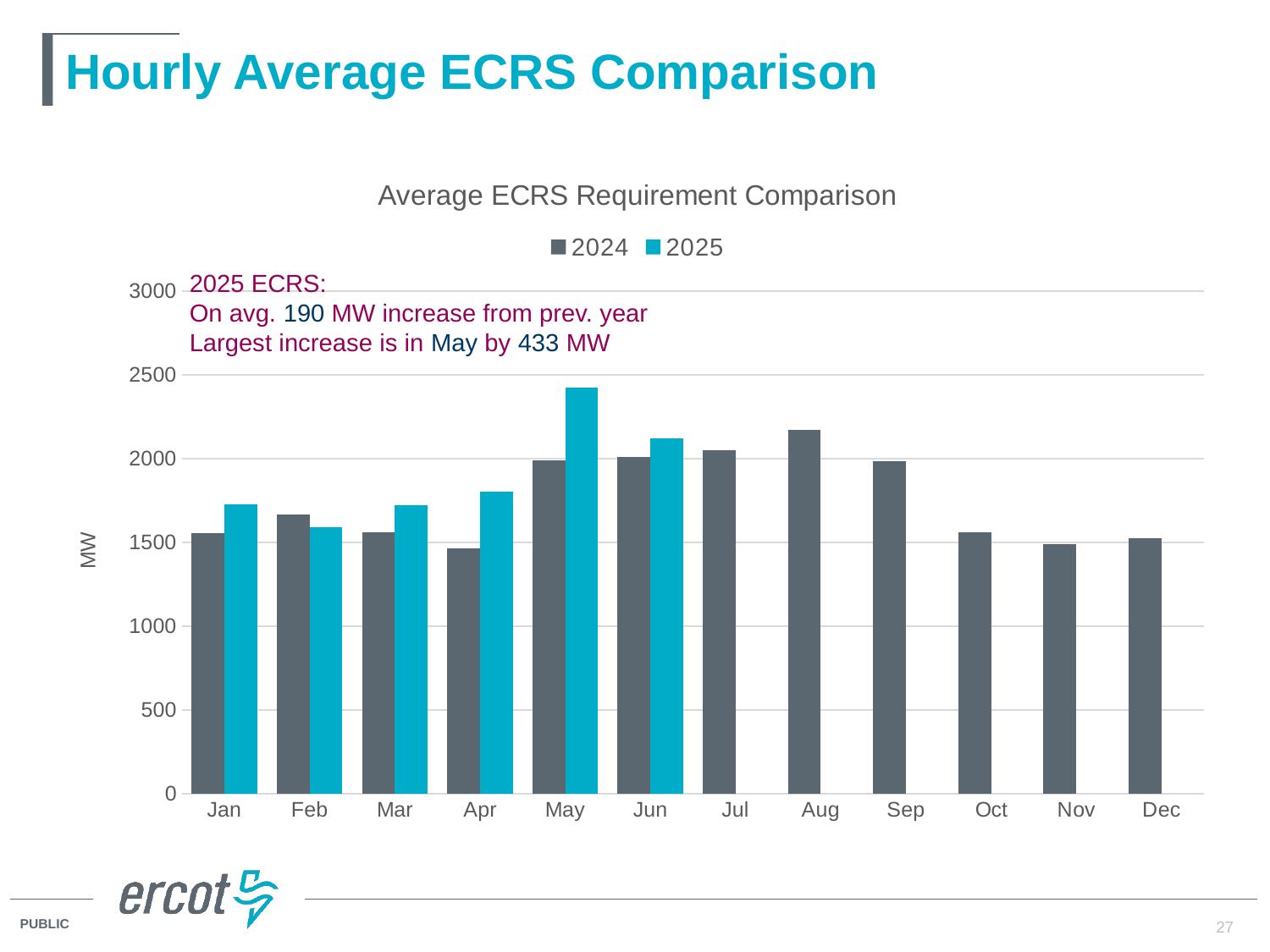
Is the 2024 value for Aug greater or less than 2000? greater Which month has the highest 2024 value? Aug How many series does the legend list? 2 Is the 2025 value for May greater or less than 2000? greater Which month has the highest 2025 value? May In Apr, which series has the larger value, 2024 or 2025? 2025 How many months are shown on the x axis? 12 What is the title of the chart? Average ECRS Requirement Comparison Which month has the lowest 2025 value? Feb What kind of chart is shown on the slide? bar chart In Feb, which series has the larger value, 2024 or 2025? 2024 Is the 2024 value for Apr greater or less than 1500? less